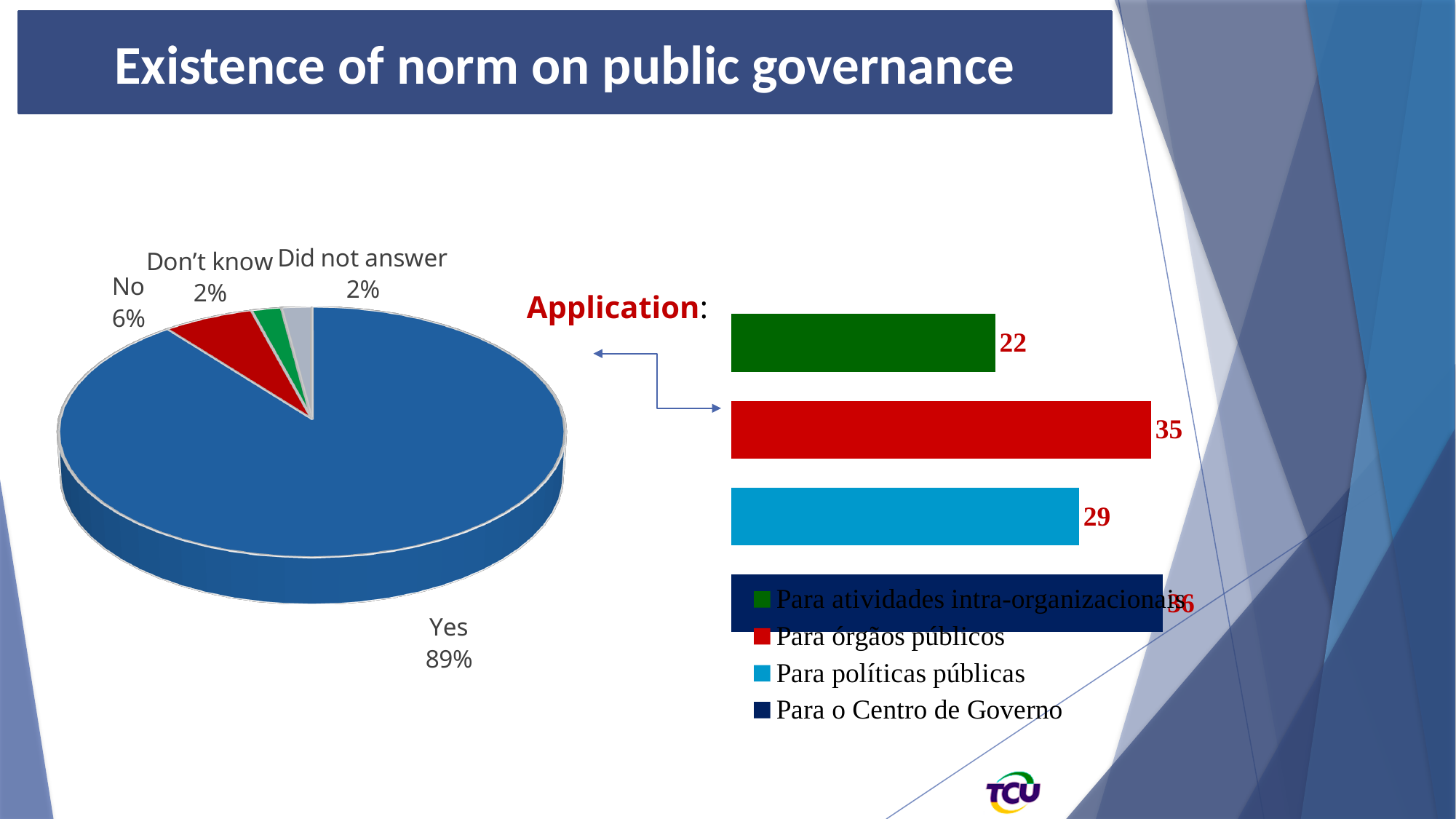
In the pie chart on the left, what percentage of respondents answered No? 6% In the bar chart on the right, what is the value for Para órgãos públicos? 35 In the bar chart on the right, what is the value for Para atividades intra-organizacionais? 22 How many slices does the pie chart on the left have? 4 In the bar chart on the right, which has the smallest value? Para atividades intra-organizacionais In the pie chart on the left, which category has the largest slice? Yes In the pie chart on the left, what percentage of respondents answered Yes? 89% What kind of chart is the chart on the left of the slide? Pie chart In the bar chart on the right, what is the value for Para políticas públicas? 29 In the pie chart on the left, what share is labelled Don't know? 2% How many entries does the legend of the bar chart on the right list? 4 In the bar chart on the right, what is the difference between the values for Para órgãos públicos and Para atividades intra-organizacionais? 13